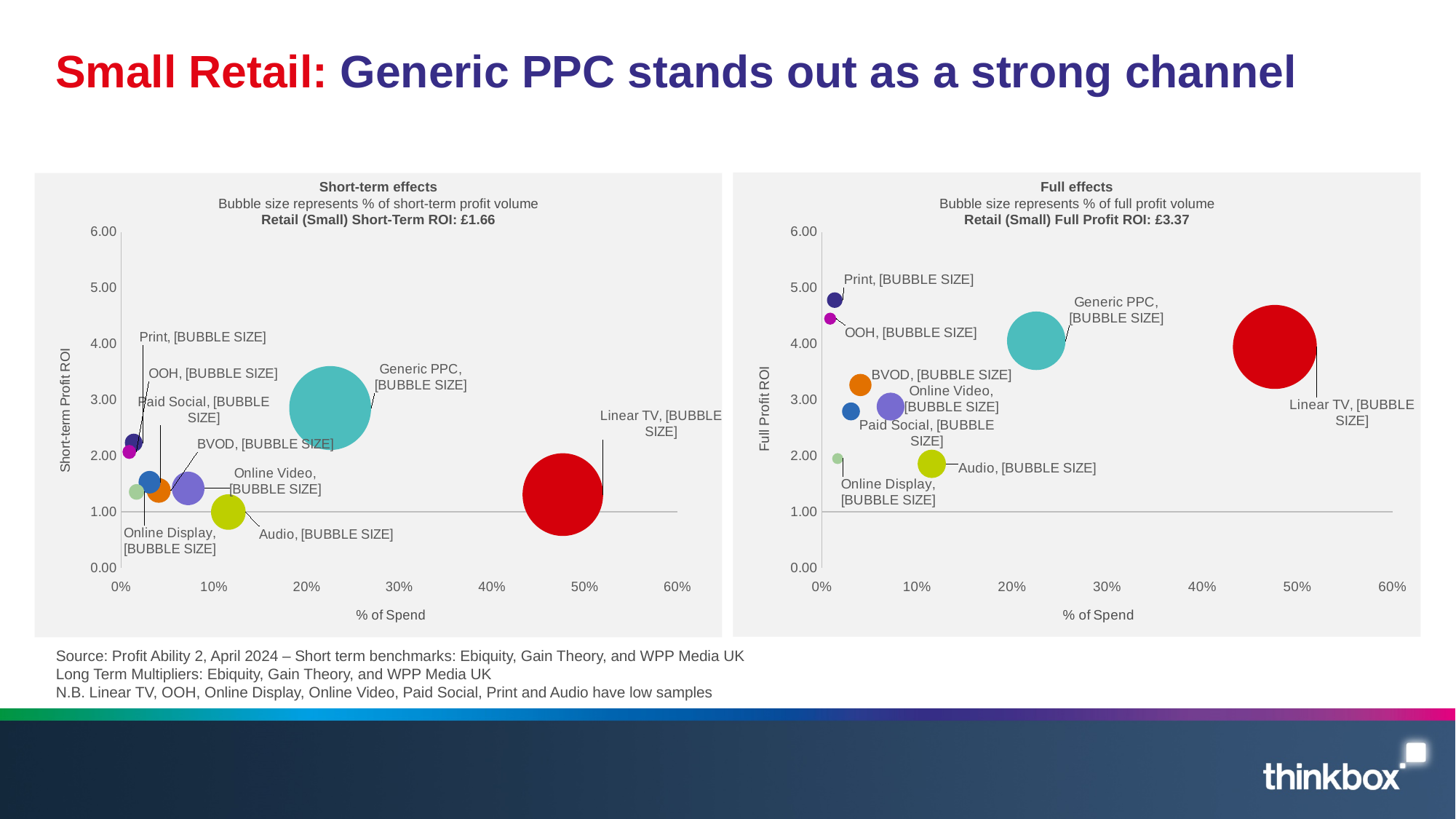
In the 'Full effects' chart, is the full profit ROI for Audio greater or less than 2.00? less In the 'Short-term effects' chart, which has the higher short-term profit ROI, Generic PPC or Linear TV? Generic PPC In the 'Full effects' chart, which channel has the highest full profit ROI? Print In the 'Short-term effects' chart, what is the Retail (Small) Short-Term ROI stated in the chart title? £1.66 How many channels are plotted in the 'Short-term effects' chart? 9 In the 'Short-term effects' chart, is the % of spend for Linear TV greater or less than 40%? greater In the 'Full effects' chart, which has the higher full profit ROI, BVOD or Paid Social? BVOD What kind of chart is the 'Short-term effects' chart? Bubble chart In the 'Short-term effects' chart, which channel has the highest short-term profit ROI? Generic PPC In the 'Full effects' chart, what is the Retail (Small) Full Profit ROI stated in the chart title? £3.37 In the 'Full effects' chart, what does the bubble size represent? % of full profit volume In the 'Short-term effects' chart, is the short-term profit ROI for Generic PPC greater or less than 2.00? greater